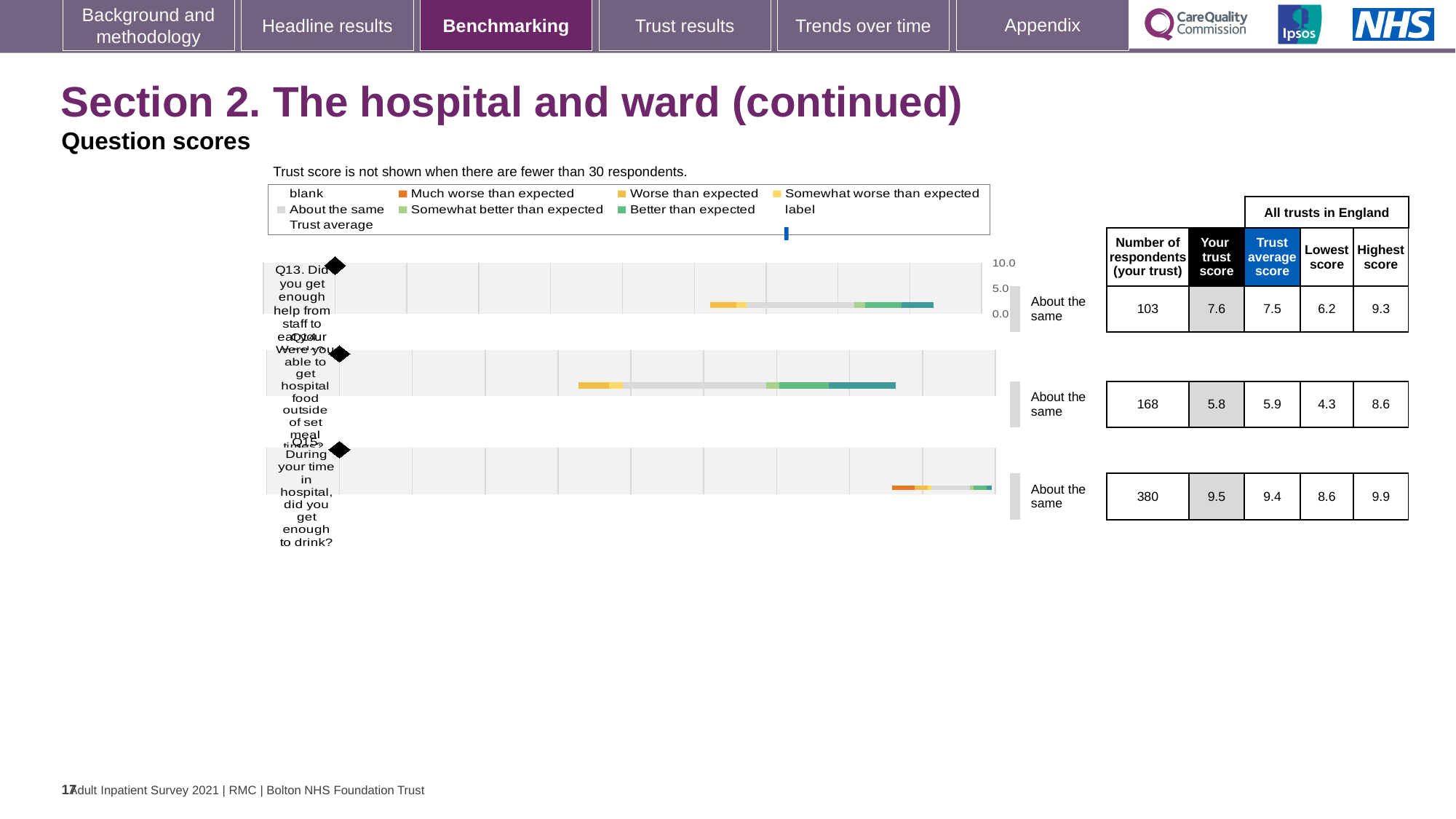
What is the highest score across all trusts in England for Q15 (did you get enough to drink?)? 9.9 How many respondents answered Q14 for this trust? 168 How many questions are plotted in the chart on this slide? 3 For Q14, which is larger: the trust score or the trust average score? Trust average score What is the trust average score for Q14 (Were you able to get hospital food outside of set meal times?)? 5.9 For Q13, what is the difference between the trust score and the trust average score? 0.1 What benchmark category is shown for Q13 on this slide? About the same What kind of chart is used to show the question scores on this slide? bar chart Which question has the lowest 'Your trust score' on this slide? Q14 For Q15, what is the difference between the highest score and the lowest score across all trusts in England? 1.3 Which question has the highest 'Your trust score' on this slide? Q15 What is the 'Your trust score' value for Q13 (Did you get enough help from staff to eat your meals?)? 7.6